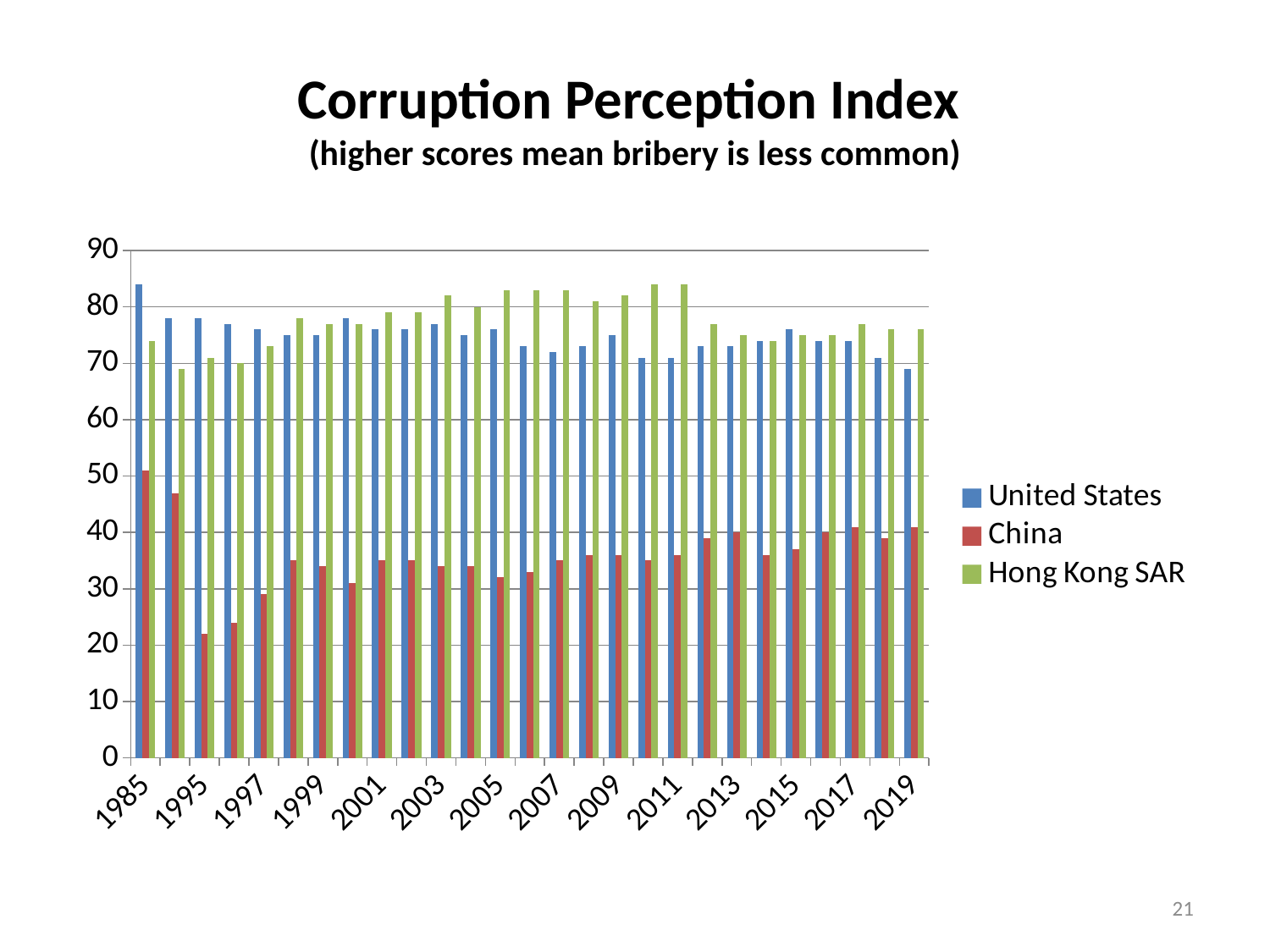
What is the title of the chart? Corruption Perception Index How many series does the legend list? 3 Is the value for China in 1995 greater or less than 20? greater Which is larger in 1985, the value for the United States or the value for China? United States Which series is shown in green? Hong Kong SAR Is the value for Hong Kong SAR in 2011 greater or less than 80? greater Which is larger in 2011, the value for Hong Kong SAR or the value for the United States? Hong Kong SAR Which series has the lowest value in 1985? China Is the value for China in 1995 greater or less than 50? less What kind of chart is shown on the slide? Bar chart Do the values for China generally rise or fall from 1995 to 2019? Rise